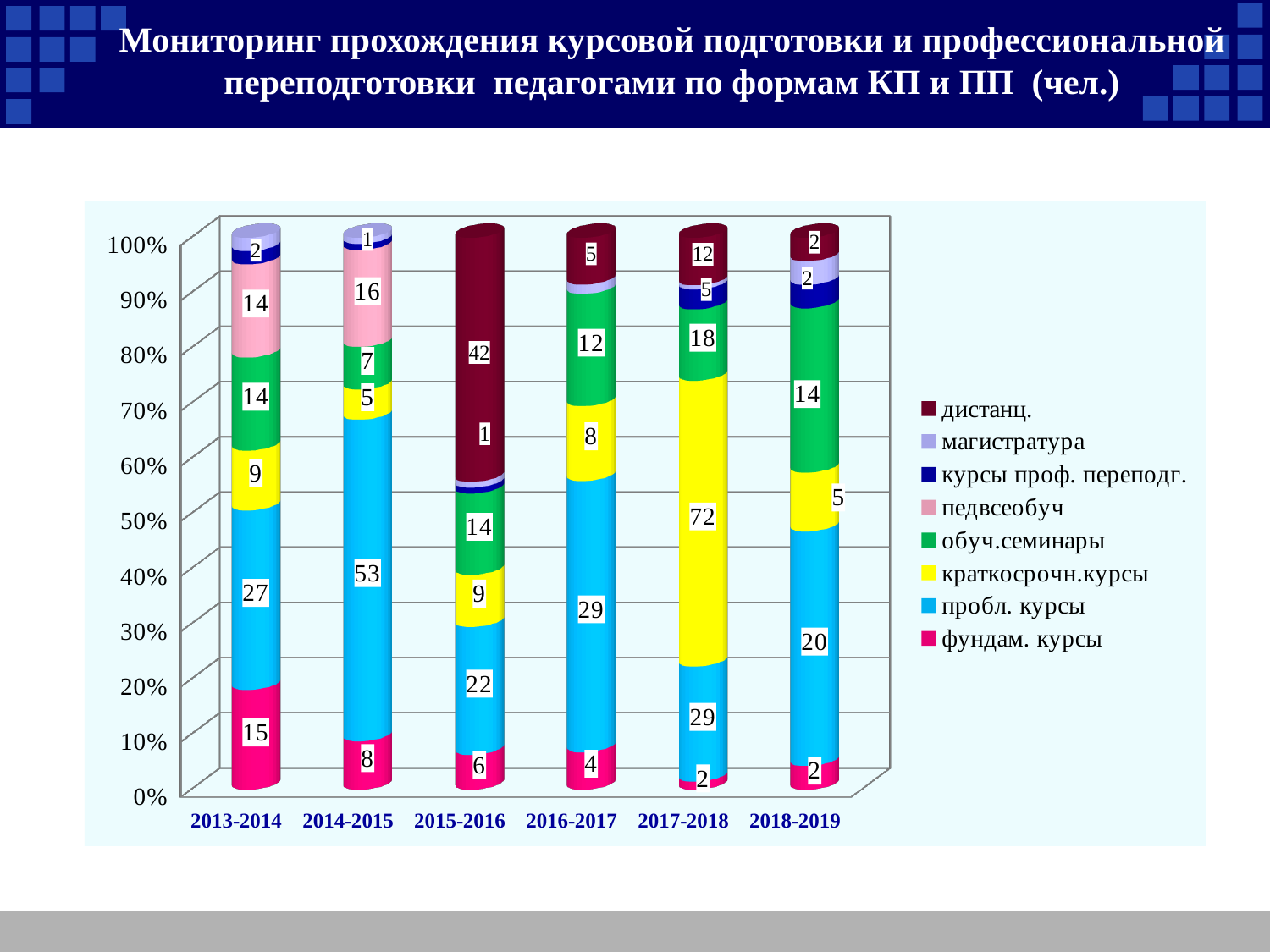
What is the value for пробл. курсы in 2014-2015? 53 In which year is the value for пробл. курсы the highest? 2014-2015 What is the difference between the пробл. курсы values in 2014-2015 and 2013-2014? 26 What is the value for фундам. курсы in 2013-2014? 15 What is the value for педвсеобуч in 2014-2015? 16 Which is larger: the дистанц. value in 2015-2016 or in 2017-2018? 2015-2016 What type of chart is shown on the slide? stacked bar chart What is the value for краткосрочн.курсы in 2017-2018? 72 How many academic-year categories are shown on the x axis? 6 How many series does the legend list? 8 What is the value for дистанц. in 2015-2016? 42 In which year is the value for краткосрочн.курсы the highest? 2017-2018